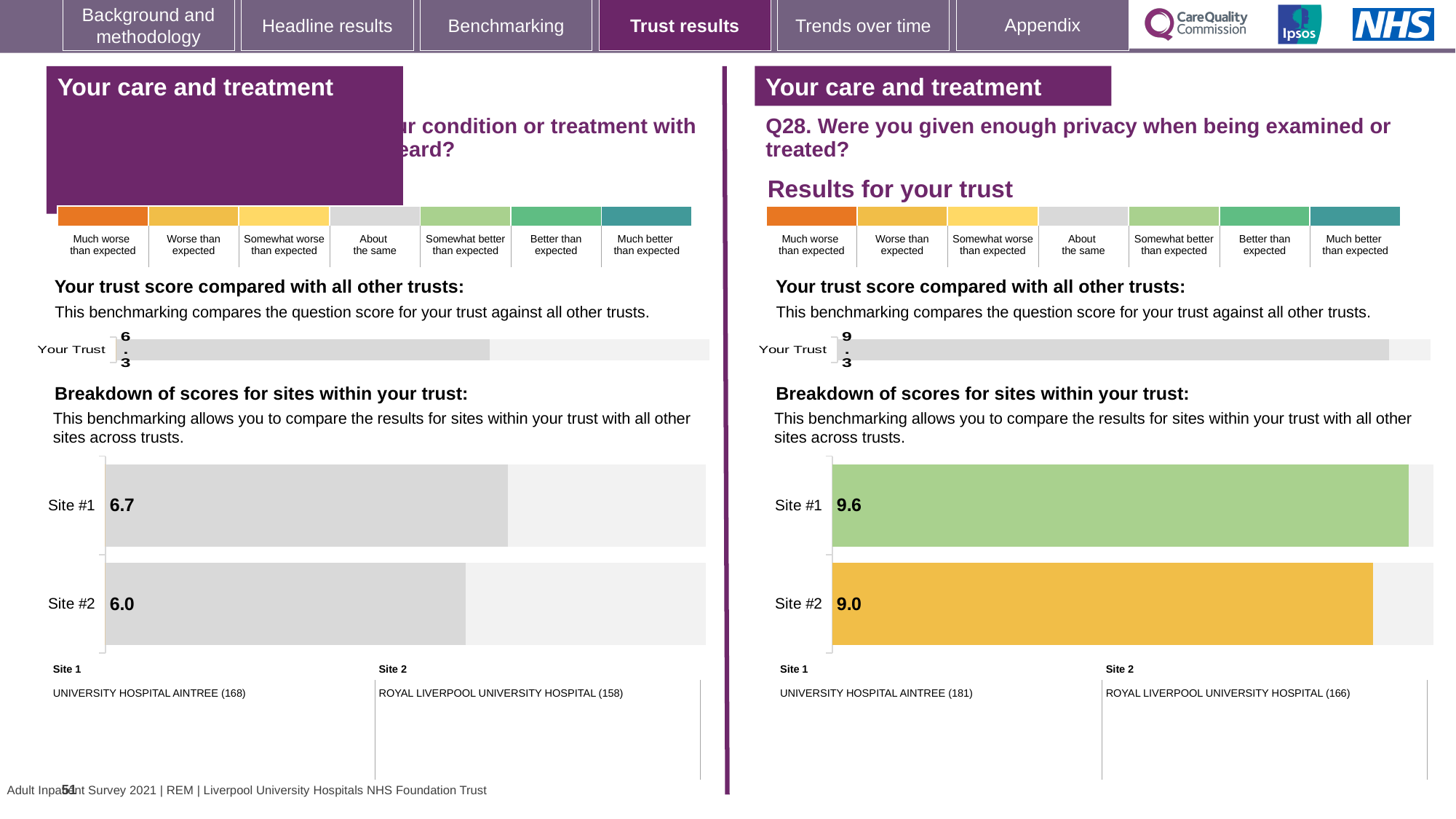
On the left-hand site breakdown chart, what is the difference between the Site #1 and Site #2 scores? 0.7 What type of chart is used for the site breakdown on the Q28 side of the slide? Bar chart On the left-hand 'Your trust score compared with all other trusts' chart, what is the score for Your Trust? 6.3 On the left-hand site breakdown chart, what is the score for Site #2? 6.0 On the left-hand site breakdown chart, what is the score for Site #1? 6.7 On the Q28 (privacy when being examined or treated) site breakdown chart, what is the score for Site #1? 9.6 On the Q28 (privacy when being examined or treated) site breakdown chart, what is the score for Site #2? 9.0 On the Q28 'Your trust score compared with all other trusts' chart, what is the score for Your Trust? 9.3 On the Q28 site breakdown chart, what is the difference between the Site #1 and Site #2 scores? 0.6 On the left-hand site breakdown chart, which site has the lower score? Site #2 On the Q28 site breakdown chart, which site has the higher score? Site #1 How many sites are shown on the Q28 site breakdown chart? 2